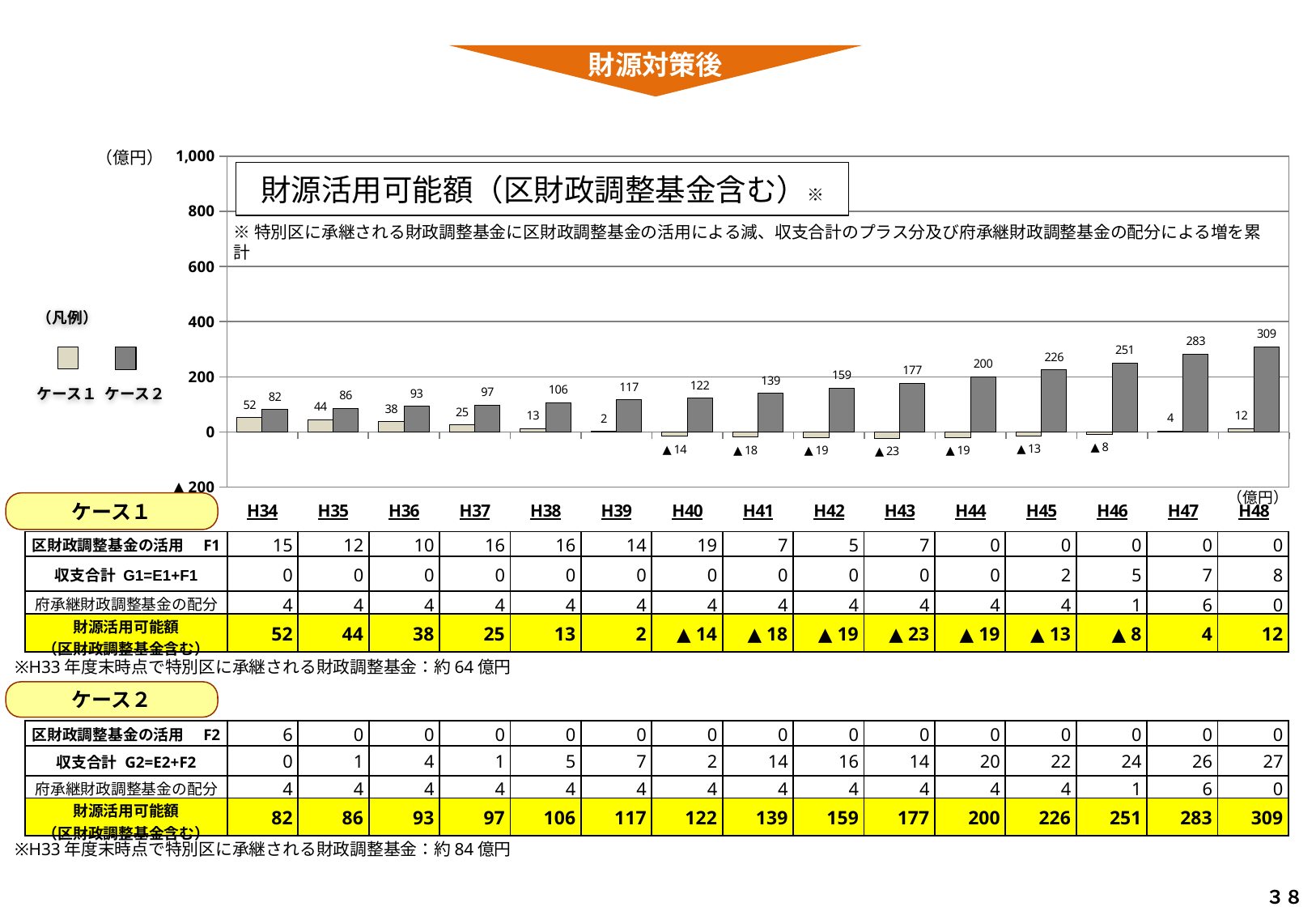
What is the value for ケース2 in H48? 309 What is the value for ケース1 in H43? ▲ 23 What is the title of the chart? 財源活用可能額（区財政調整基金含む） What kind of chart is shown on the slide? bar chart In which year is ケース2 highest? H48 What is the difference between ケース2 and ケース1 in H34? 30 Do the ケース2 values rise or fall from H34 to H48? rise How many fiscal-year categories are plotted along the x axis? 15 Which is larger in H40, ケース1 or ケース2? ケース2 How many series does the legend list? 2 In which year is ケース1 lowest? H43 What is the value for ケース1 in H34? 52